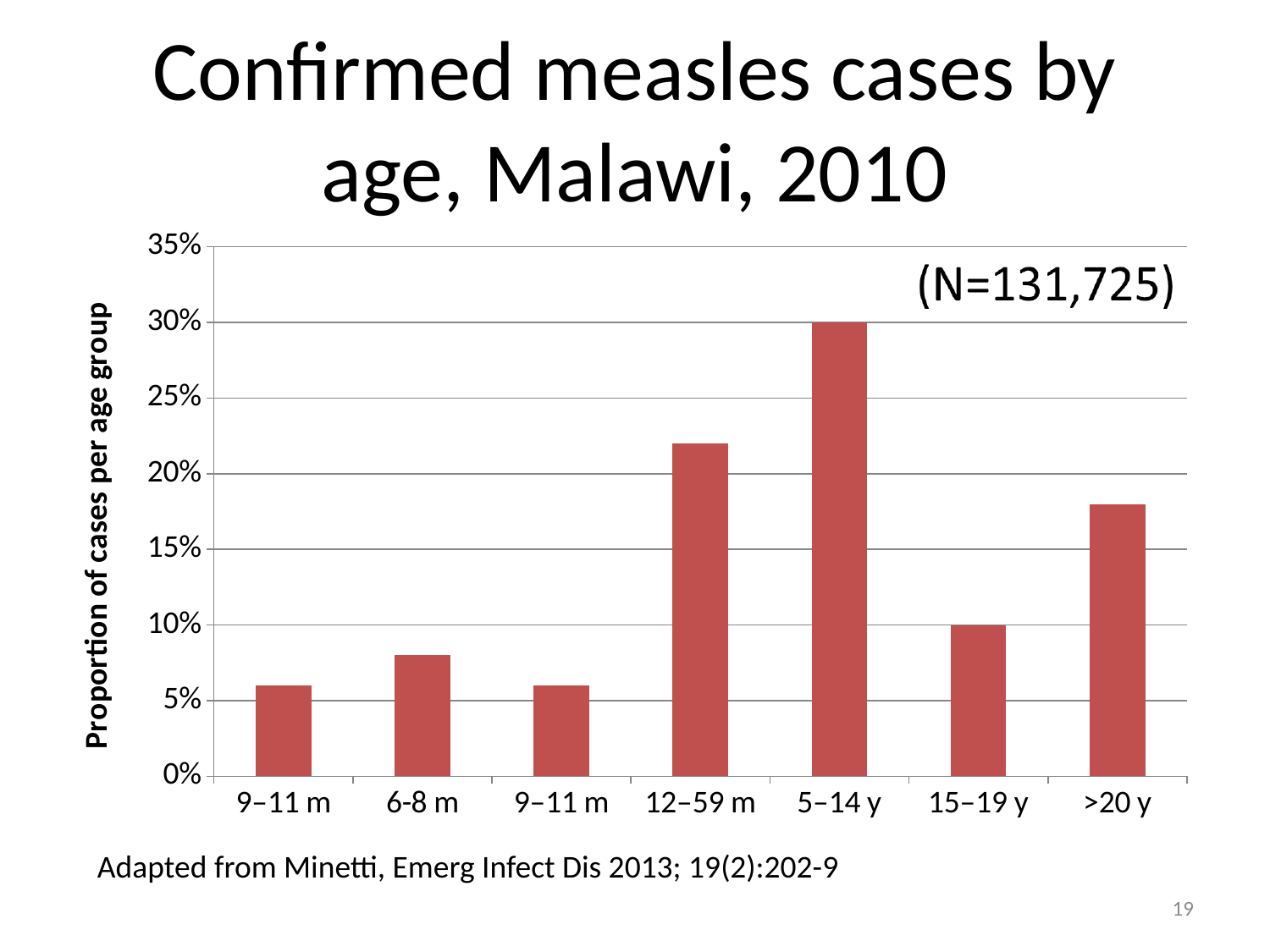
How many age-group categories are plotted on the x axis? 7 Which has a larger proportion of cases, 6-8 m or 15–19 y? 15–19 y Is the value for 12–59 m greater or less than 20%? greater What kind of chart is shown on the slide? bar chart What is the label of the y axis? Proportion of cases per age group What is the proportion of cases for the 15–19 y age group? 10% What is the proportion of cases for the 5–14 y age group? 30% What total number of cases (N) is shown on the chart? N=131,725 Which has a larger proportion of cases, 12–59 m or >20 y? 12–59 m Which age group has the highest proportion of cases? 5–14 y Is the value for 6-8 m greater or less than 10%? less Is the value for >20 y greater or less than 20%? less